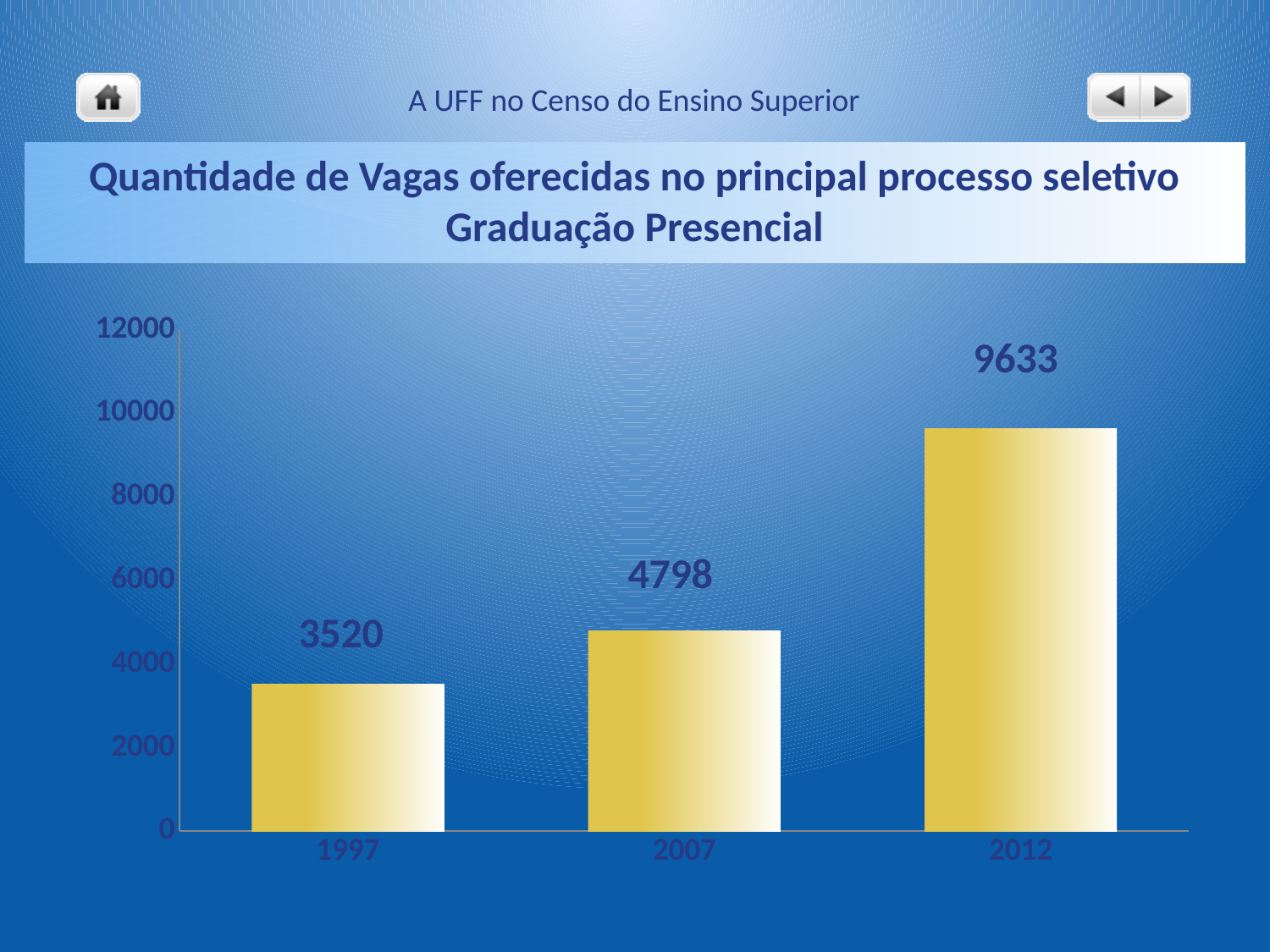
What is the difference between the values for 2007 and 1997? 1278 What kind of chart is shown on the slide? bar chart Is the value for 2012 greater or less than 8000? greater Which year has the lowest value? 1997 Which is larger, the value for 1997 or the value for 2007? 2007 What is the value for 2007? 4798 What is the difference between the values for 2012 and 2007? 4835 What is the value for 2012? 9633 Which year has the highest value? 2012 Do the values rise or fall from 1997 to 2012? rise How many years are shown on the x axis? 3 What is the value for 1997? 3520